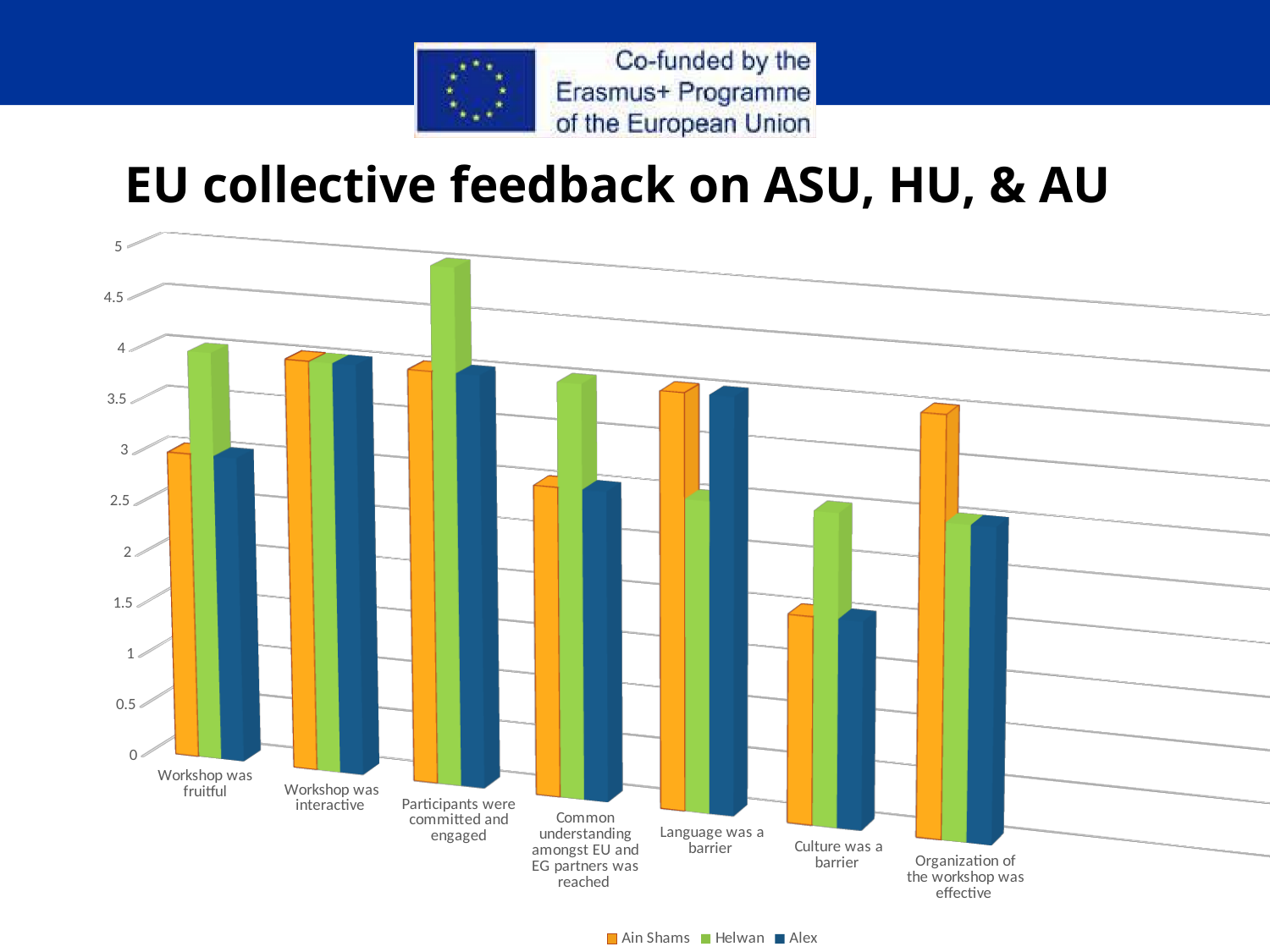
Which category has the lowest Ain Shams value? Culture was a barrier How many series does the legend list? 3 For 'Workshop was fruitful', which is larger: the Helwan value or the Ain Shams value? Helwan How many categories are shown along the x axis? 7 For 'Language was a barrier', which is larger: the Ain Shams value or the Helwan value? Ain Shams What kind of chart is shown on the slide? bar chart Which category has the highest Helwan value? Participants were committed and engaged What is the title of the chart? EU collective feedback on ASU, HU, & AU Is the Ain Shams value for 'Organization of the workshop was effective' greater or less than 3? greater Is the Helwan value for 'Participants were committed and engaged' greater or less than 4? greater